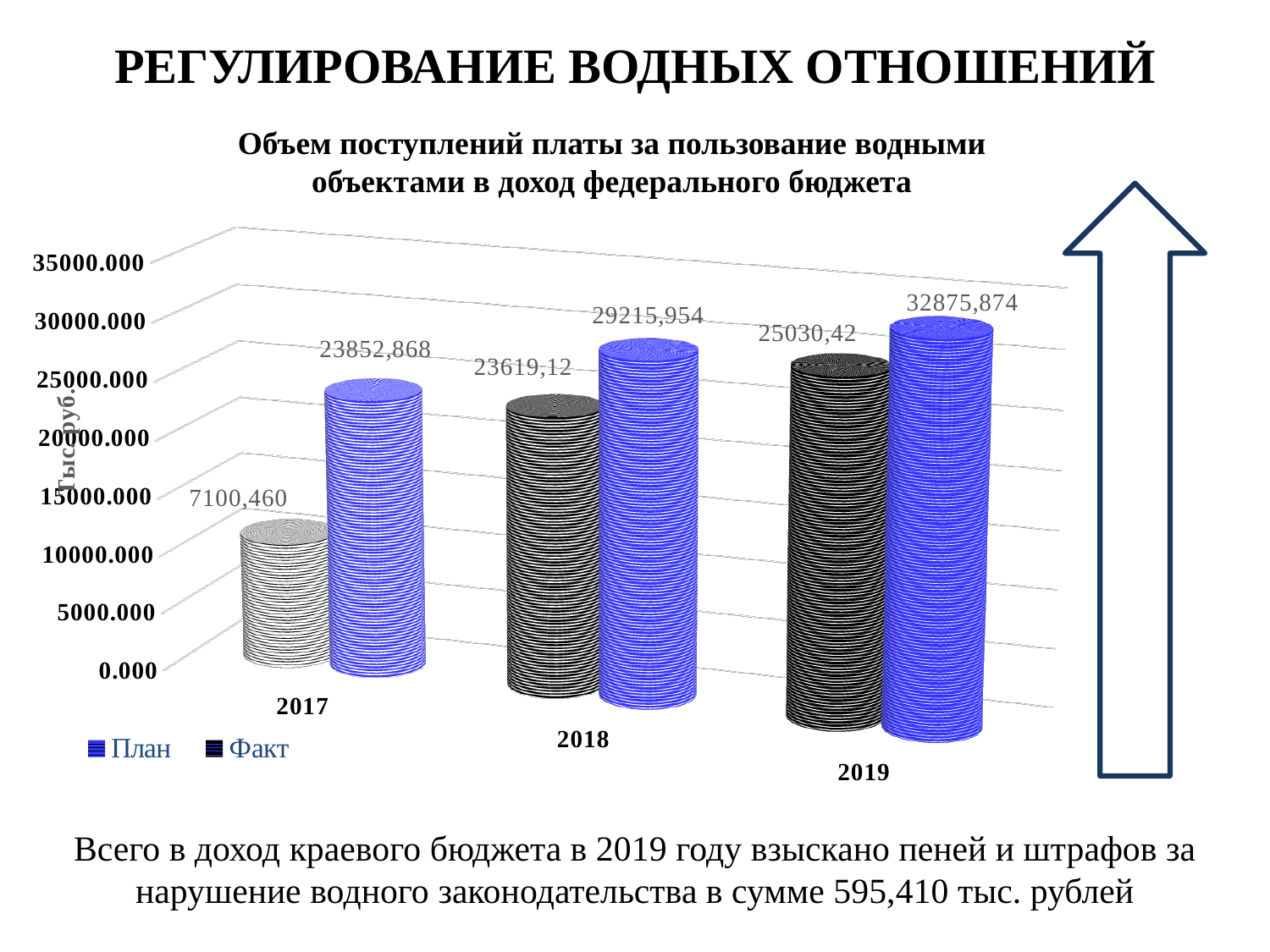
What is the План value for 2017? 23852,868 What is the Факт value for 2017? 7100,460 What is the difference between the План and Факт values for 2019? 7845,454 Which year has the highest План value? 2019 Which is larger in 2018: the План value or the Факт value? План What is the Факт value for 2018? 23619,12 How many series does the legend list? 2 Which year has the lowest Факт value? 2017 How many years are shown on the x axis? 3 Is the Факт value for 2019 greater or less than 20000.000? greater Does the Факт value rise or fall from 2017 to 2019? rise What is the План value for 2019? 32875,874